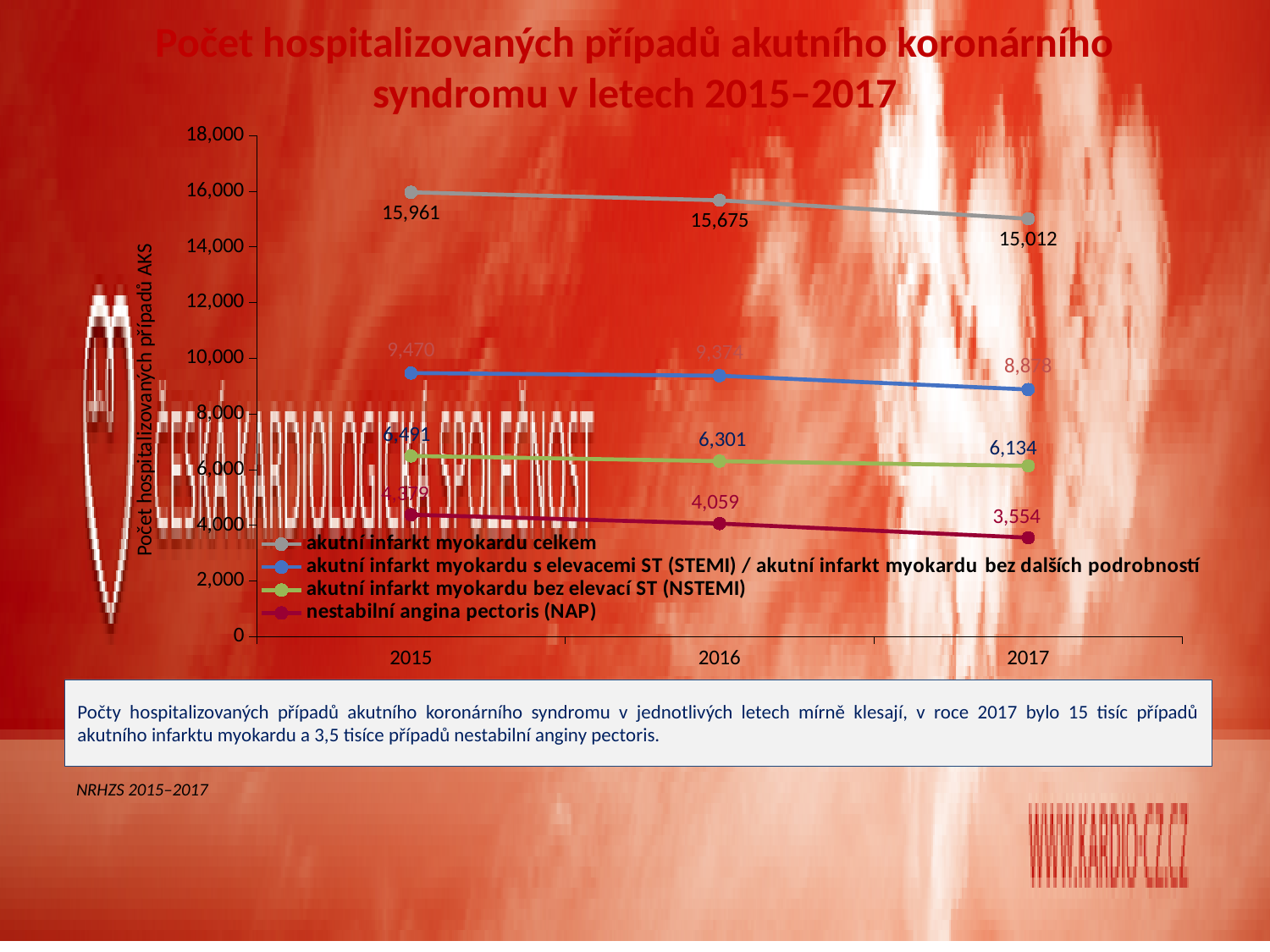
Is the 2017 value for akutní infarkt myokardu s elevacemi ST (STEMI) greater or less than 10,000? less What kind of chart is shown on the slide? line chart What is the value for akutní infarkt myokardu celkem in 2017? 15,012 Does the akutní infarkt myokardu celkem series rise or fall from 2015 to 2017? fall By how much did akutní infarkt myokardu celkem decrease from 2015 to 2017? 949 What is the difference between the nestabilní angina pectoris (NAP) values in 2016 and 2017? 505 What is the value for akutní infarkt myokardu bez elevací ST (NSTEMI) in 2016? 6,301 How many series does the legend list? 4 What is the value for akutní infarkt myokardu celkem in 2015? 15,961 Which series has the highest values across all years? akutní infarkt myokardu celkem How many years are shown on the x axis? 3 What is the value for nestabilní angina pectoris (NAP) in 2017? 3,554